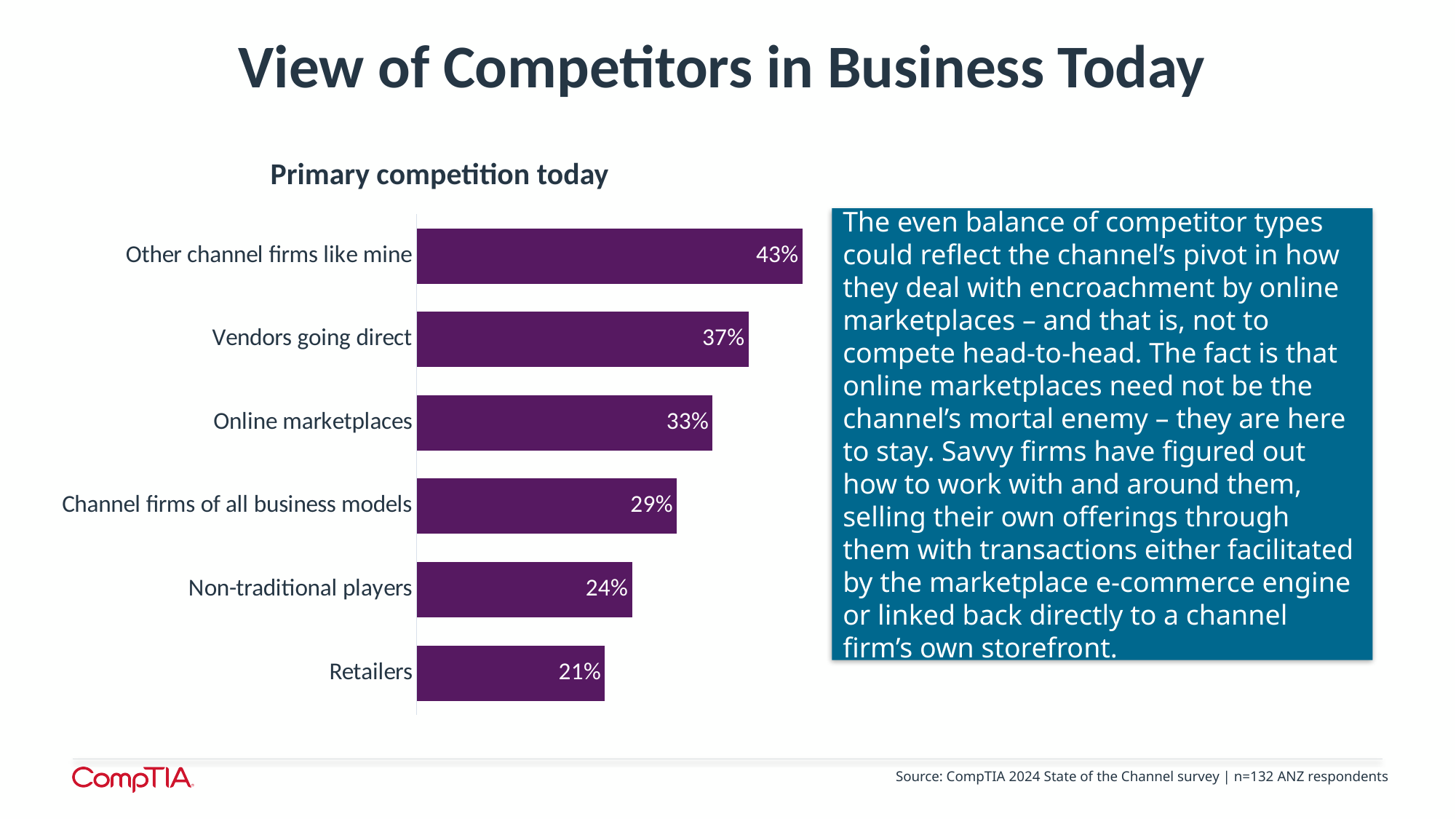
What percentage is shown for Online marketplaces? 33% How many categories are shown in the chart? 6 What is the difference between the values for Channel firms of all business models and Non-traditional players? 5% What is the difference between the values for Other channel firms like mine and Vendors going direct? 6% What percentage is shown for Other channel firms like mine? 43% What is the value for Retailers? 21% Which category has the highest value? Other channel firms like mine What is the value for Vendors going direct? 37% What kind of chart is shown on the slide? Bar chart Which is larger, the value for Online marketplaces or the value for Non-traditional players? Online marketplaces Which category has the lowest value? Retailers What is the title of the chart? Primary competition today